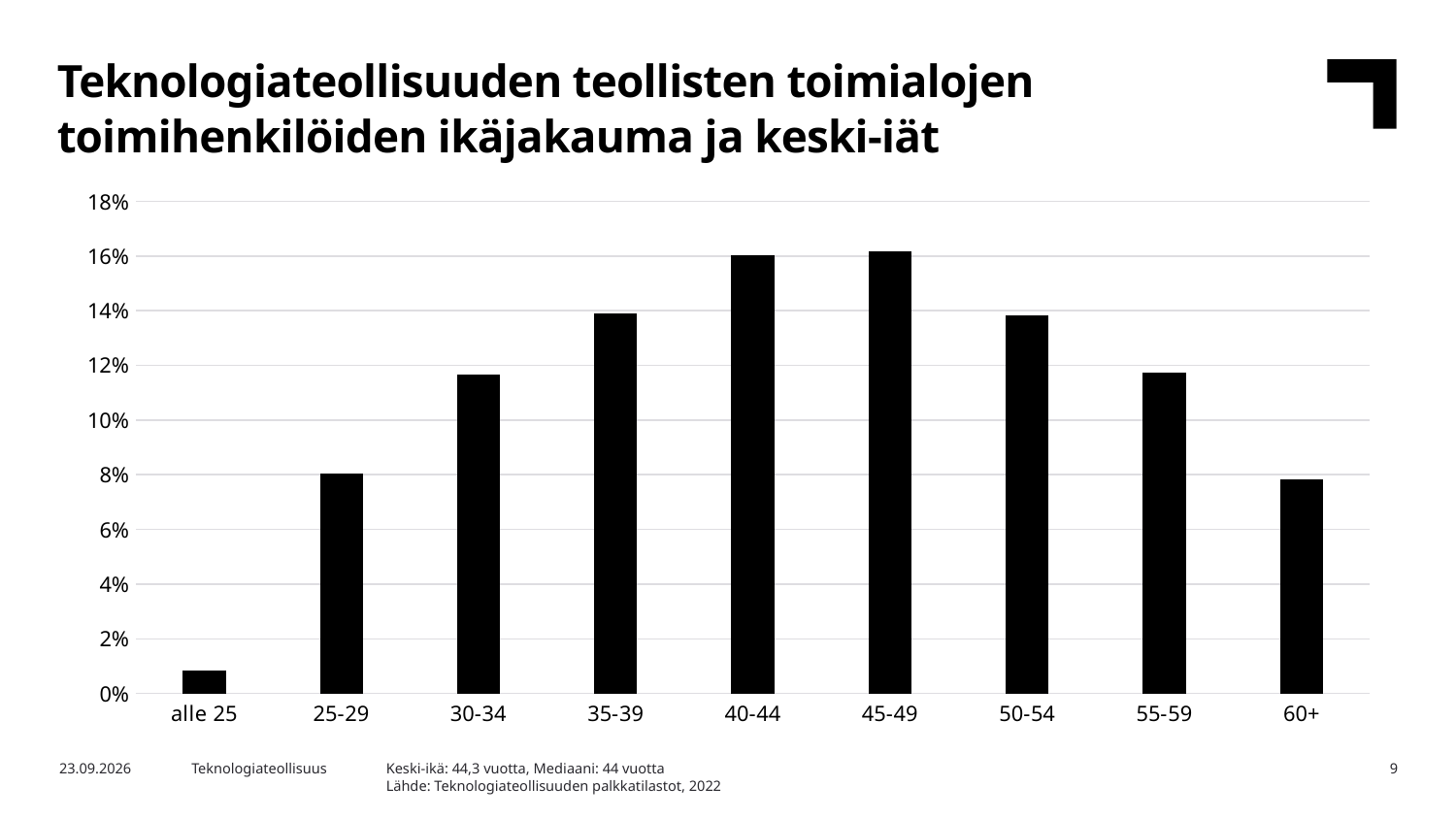
Is the value for 50-54 greater or less than 12%? greater How do the values change across the age groups from left to right? They rise to a peak around 40-49 and then fall Which is larger, the value for 60+ or the value for 35-39? 35-39 Is the value for alle 25 greater or less than 2%? less How many age groups are shown on the x axis of the chart? 9 Which is larger, the value for 40-44 or the value for 25-29? 40-44 Is the value for 40-44 greater or less than 14%? greater What kind of chart is shown on the slide? bar chart Which age group has the lowest share in the chart? alle 25 According to the note below the chart, what is the average age (keski-ikä)? 44,3 vuotta